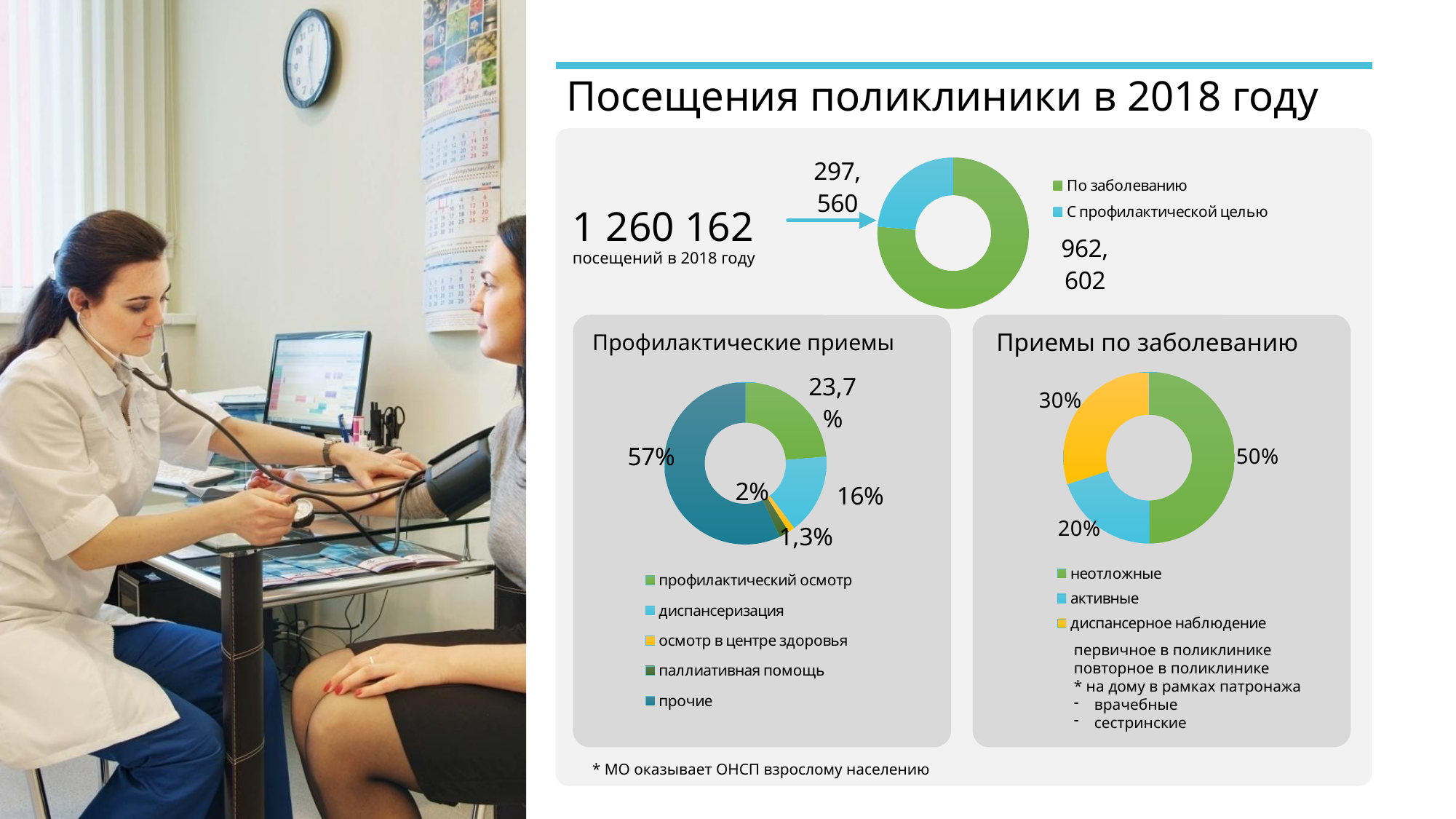
In the 'Профилактические приемы' chart, which category has the smallest share? осмотр в центре здоровья In the 'Приемы по заболеванию' chart, which category has the largest share? неотложные In the top donut chart, how many visits were 'С профилактической целью'? 297,560 In the top donut chart, how many visits were 'По заболеванию'? 962,602 In the top donut chart, which category has the larger number of visits? По заболеванию In the 'Профилактические приемы' chart, what share is 'профилактический осмотр'? 23,7% How many categories does the legend of the 'Профилактические приемы' chart list? 5 In the 'Приемы по заболеванию' chart, what share is 'диспансерное наблюдение'? 30% In the 'Приемы по заболеванию' chart, what is the difference between the shares of 'неотложные' and 'активные'? 30% In the 'Профилактические приемы' chart, what share is 'прочие'? 57% In the 'Профилактические приемы' chart, what share is 'диспансеризация'? 16% How many series does the legend of the top donut chart list? 2